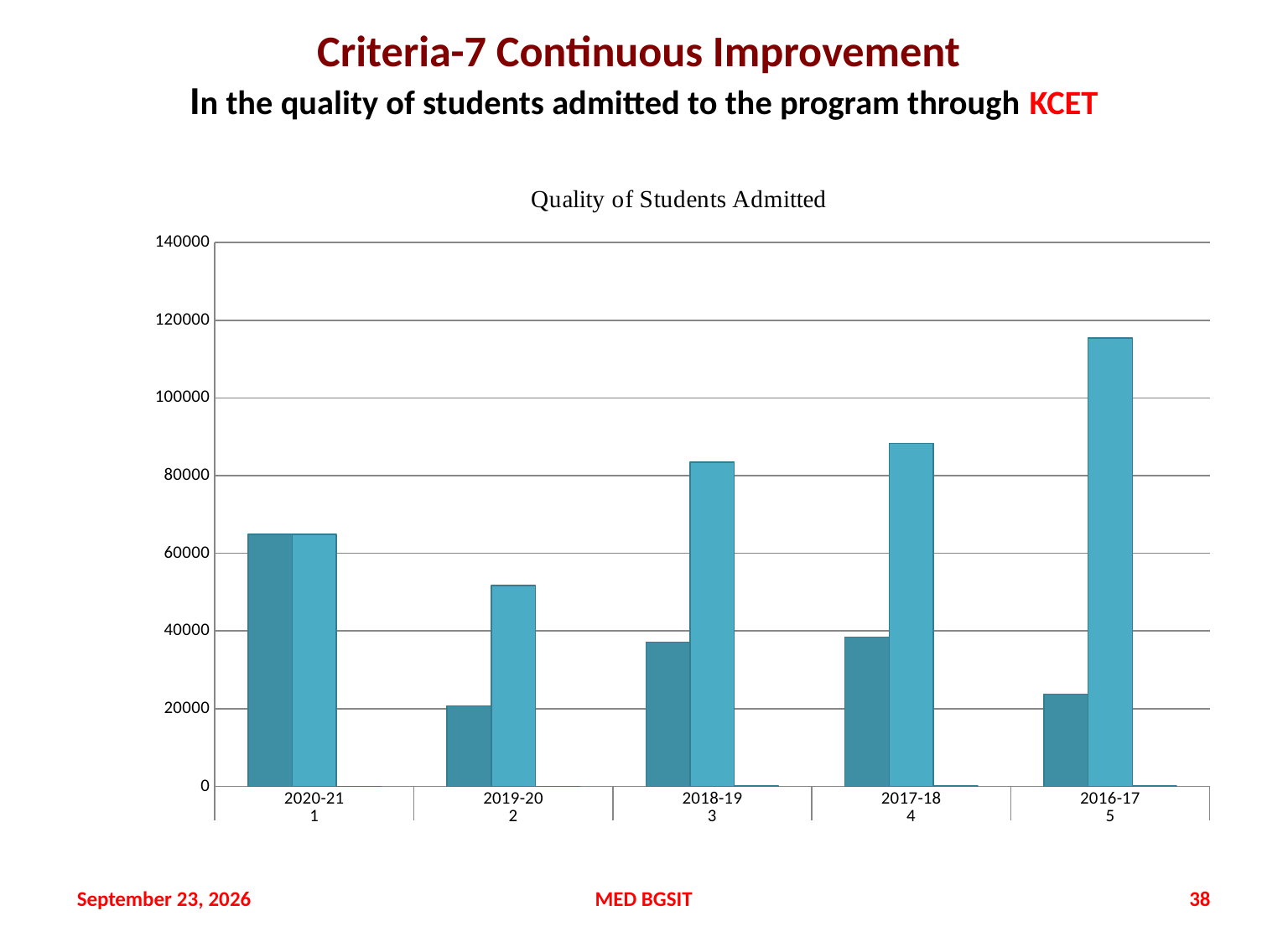
Is the light-blue bar for 2016-17 greater or less than 100000? greater What is the title of the chart? Quality of Students Admitted For 2016-17, which is larger: the dark-teal bar or the light-blue bar? the light-blue bar Is the dark-teal bar for 2020-21 greater or less than 60000? greater Which year has the tallest dark-teal bar? 2020-21 Which year has the shortest light-blue bar? 2019-20 Is the light-blue bar for 2019-20 greater or less than 60000? less Which year has the tallest light-blue bar? 2016-17 Which year has the shortest dark-teal bar? 2019-20 What type of chart is shown on the slide? bar chart How many year categories are shown on the x axis of the chart? 5